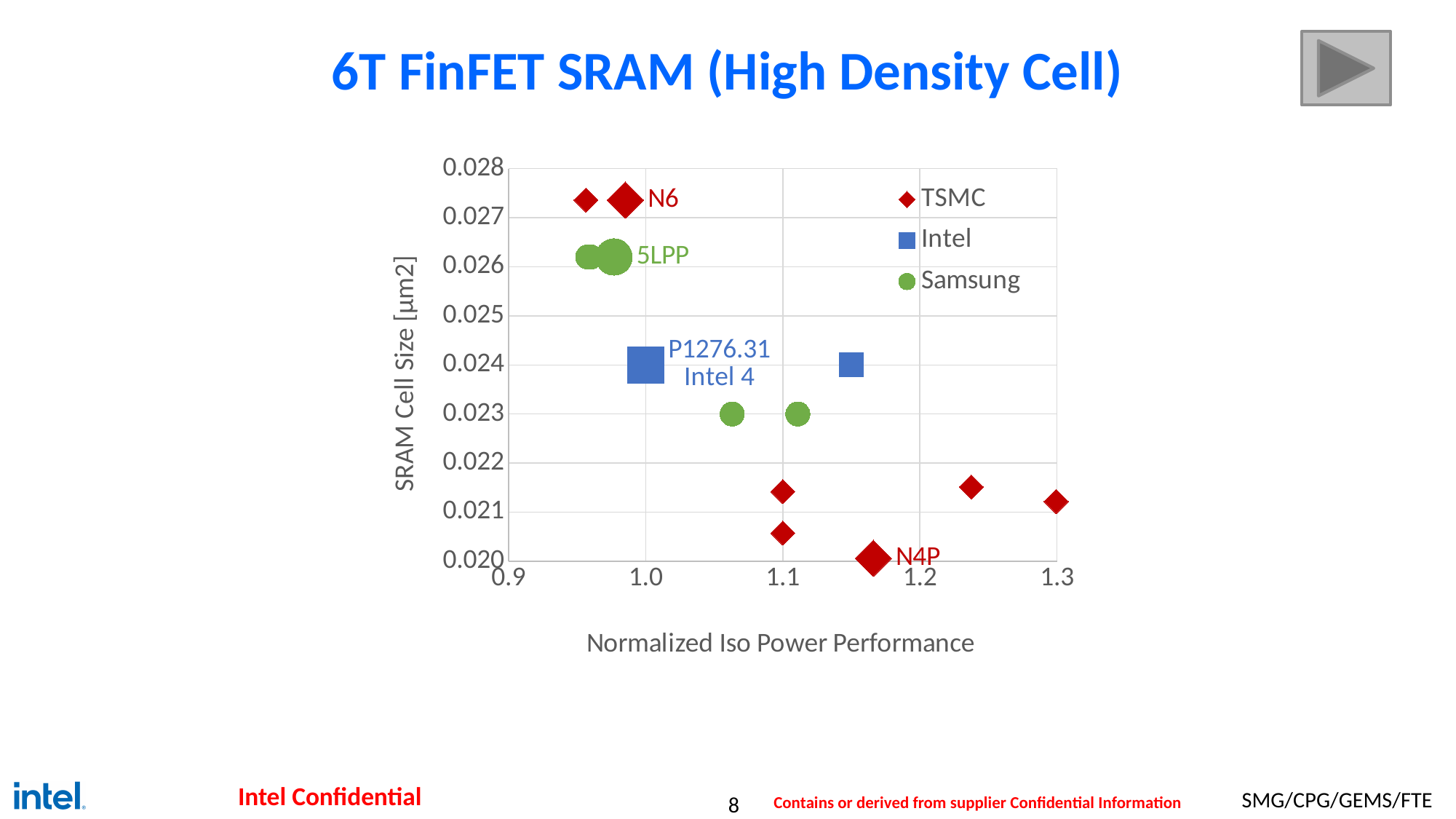
Is the SRAM cell size for P1276.31 Intel 4 greater or less than 0.025? less Is the SRAM cell size for 5LPP greater or less than 0.027? less Is the SRAM cell size for N6 greater or less than 0.026? greater How many Intel data points are plotted on the chart? 2 How many series does the legend list? 3 What kind of chart is shown on the slide? scatter chart What is the label of the y axis? SRAM Cell Size [µm2] Which of the labeled points has the largest SRAM cell size? N6 Which of the labeled points has the smallest SRAM cell size? N4P Which companies are listed in the chart legend? TSMC, Intel, Samsung Which has the larger SRAM cell size, N6 or 5LPP? N6